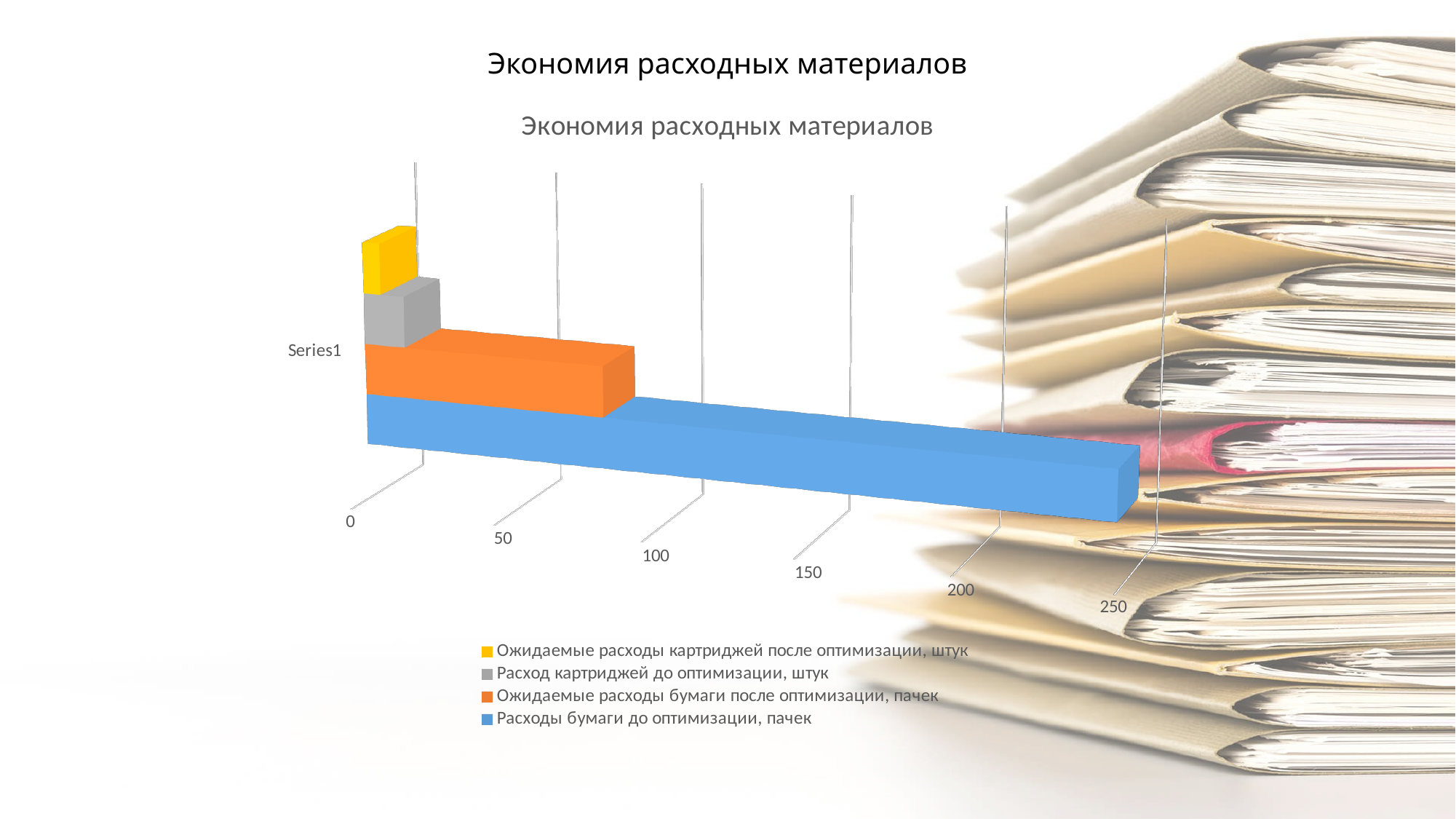
Which series has the highest value? Расходы бумаги до оптимизации, пачек Which is larger: 'Ожидаемые расходы бумаги после оптимизации, пачек' or 'Расход картриджей до оптимизации, штук'? Ожидаемые расходы бумаги после оптимизации, пачек Is the value for 'Расход картриджей до оптимизации, штук' greater or less than 50? less Is the value for 'Ожидаемые расходы бумаги после оптимизации, пачек' greater or less than 100? less What kind of chart is shown on the slide? bar chart Which colour represents 'Расходы бумаги до оптимизации, пачек' in the legend? blue How many categories are shown on the category axis? 1 Is the value for 'Расходы бумаги до оптимизации, пачек' greater or less than 200? greater What is the title of the chart? Экономия расходных материалов How many series does the legend list? 4 Which is larger: 'Расходы бумаги до оптимизации, пачек' or 'Ожидаемые расходы бумаги после оптимизации, пачек'? Расходы бумаги до оптимизации, пачек